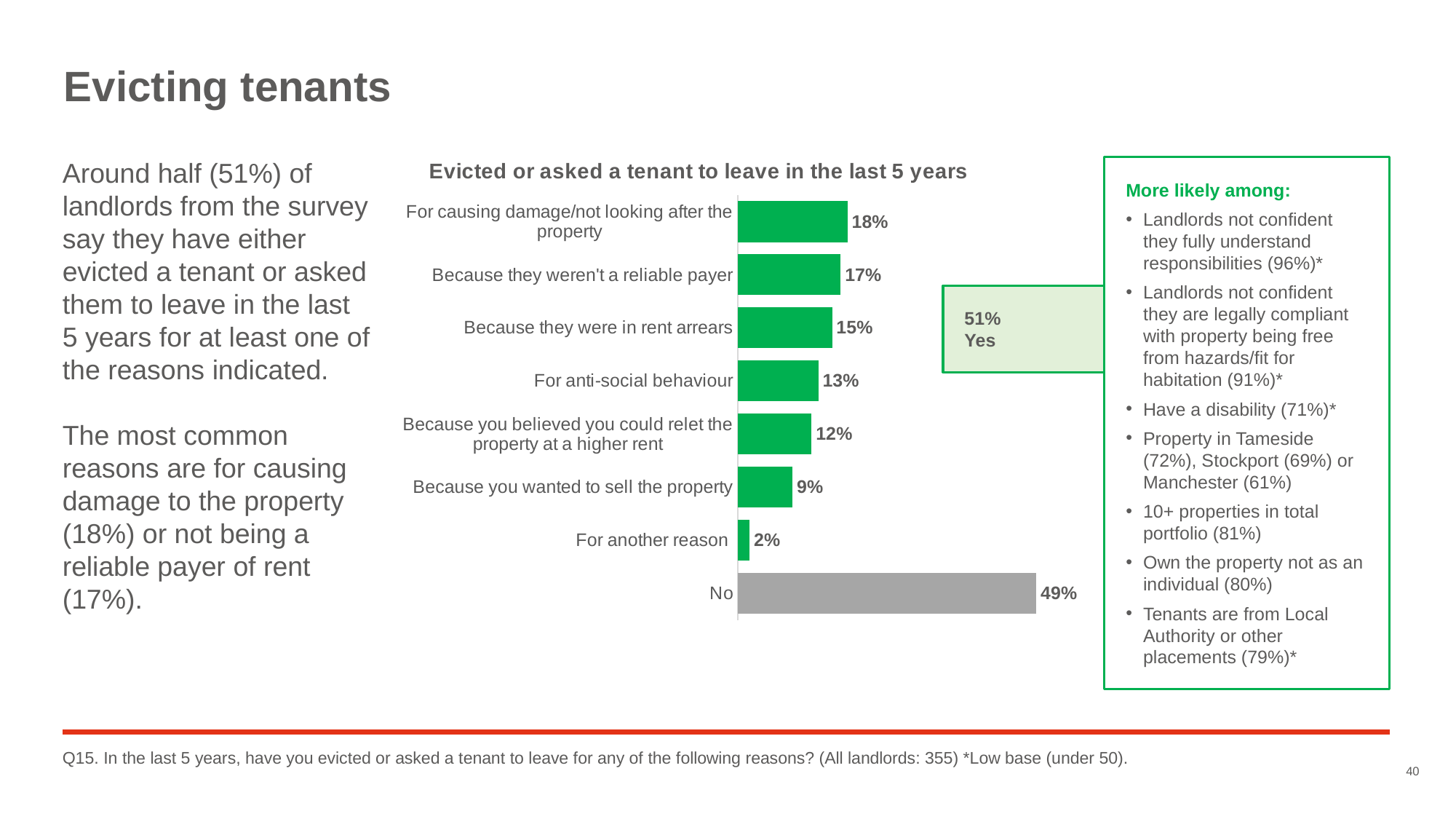
What percentage is shown in the 'Yes' box next to the chart? 51% What is the value for 'For causing damage/not looking after the property'? 18% How many categories are shown in the chart? 8 What is the title of the chart? Evicted or asked a tenant to leave in the last 5 years What kind of chart is shown on the slide? Bar chart What is the value for 'No'? 49% Which is larger: 'For anti-social behaviour' or 'Because you wanted to sell the property'? For anti-social behaviour What is the value for 'For another reason'? 2% What is the difference between 'For causing damage/not looking after the property' and 'Because they weren't a reliable payer'? 1% What is the value for 'Because they were in rent arrears'? 15% Which category has the highest value in the chart? No Which category has the lowest value in the chart? For another reason